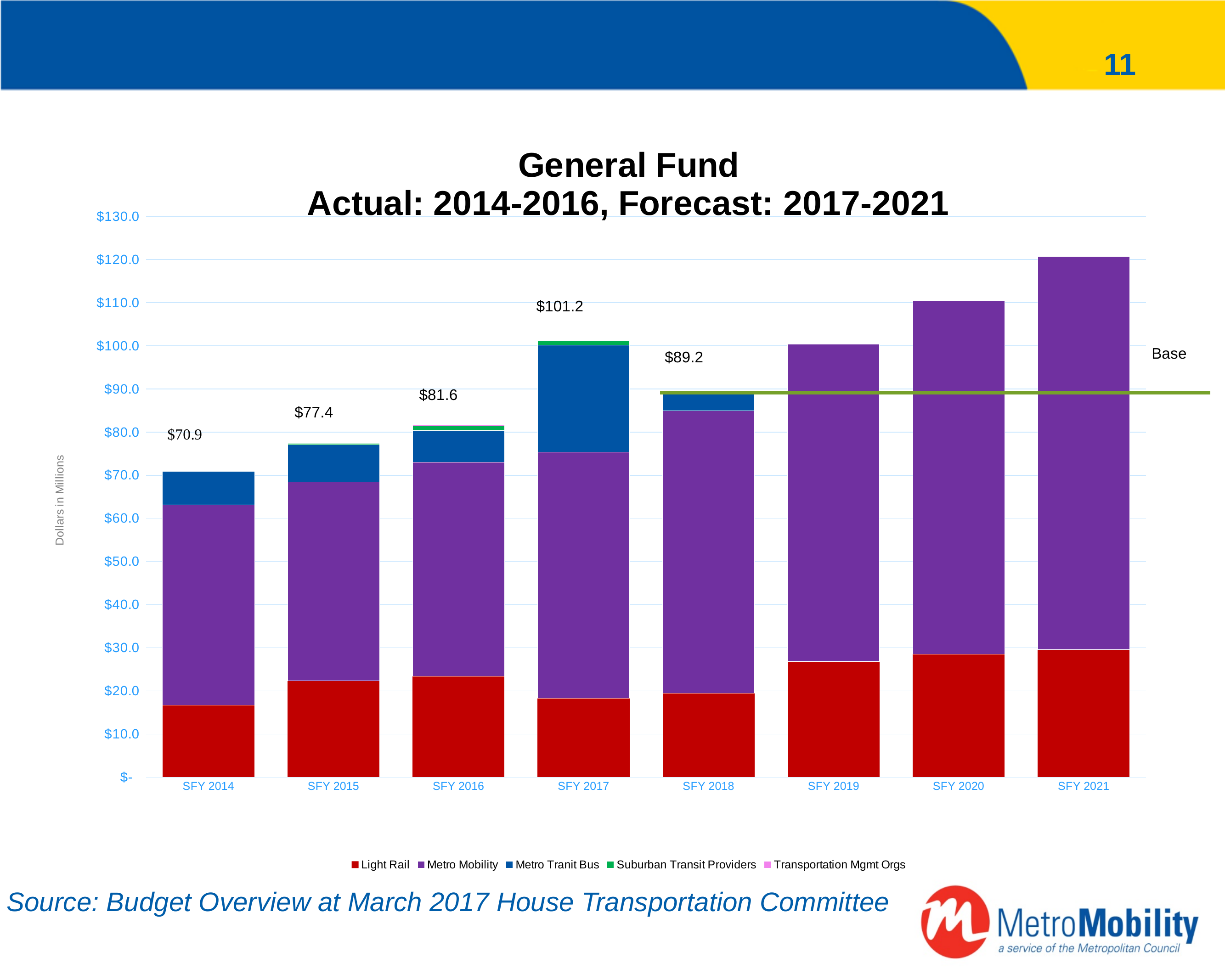
How many fiscal years are shown on the x axis? 8 Which fiscal year has the shortest stacked bar? SFY 2014 How many series does the legend list? 5 Is the total bar for SFY 2021 greater or less than $110.0? greater Which fiscal year has the tallest stacked bar? SFY 2021 Which has the larger labeled total, SFY 2017 or SFY 2018? SFY 2017 What is the difference between the labeled totals for SFY 2015 and SFY 2014? $6.5 What is the difference between the labeled totals for SFY 2017 and SFY 2016? $19.6 What is the total General Fund value labeled for SFY 2014? $70.9 What is the total General Fund value labeled for SFY 2017? $101.2 What is the total General Fund value labeled for SFY 2018? $89.2 Is the total bar for SFY 2019 greater or less than $110.0? less